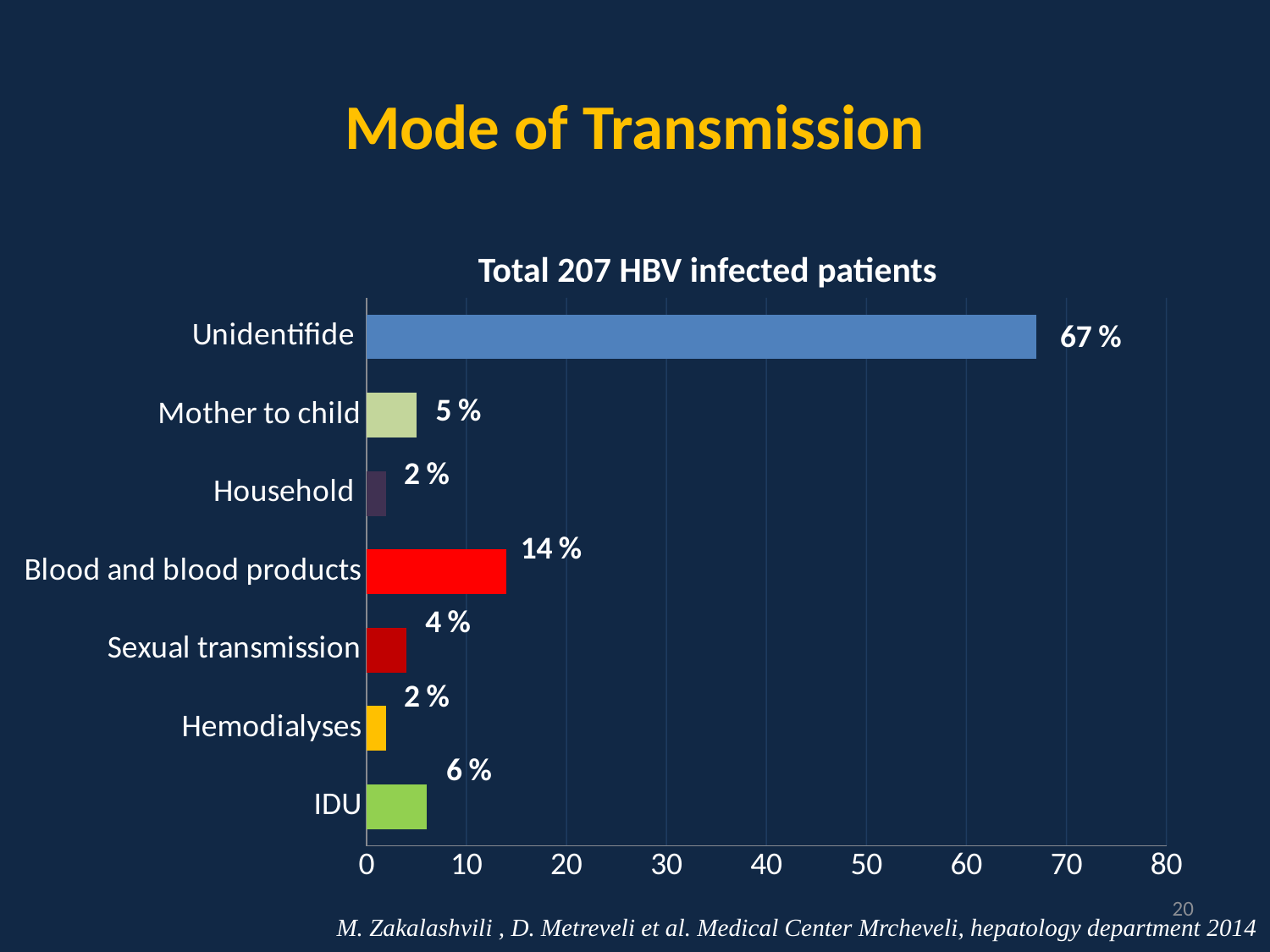
What is the difference between the values for IDU and Sexual transmission? 2 % What is the title of the chart? Total 207 HBV infected patients What kind of chart is shown on the slide? bar chart Which mode of transmission has the highest value? Unidentifide Is the value for Unidentifide greater or less than 60? greater What is the value for Mother to child? 5 % Which is larger, the value for Blood and blood products or the value for IDU? Blood and blood products How many categories are shown in the chart? 7 What is the value for Unidentifide? 67 % What is the difference between the values for Unidentifide and Blood and blood products? 53 % What is the value for IDU? 6 % What is the value for Blood and blood products? 14 %